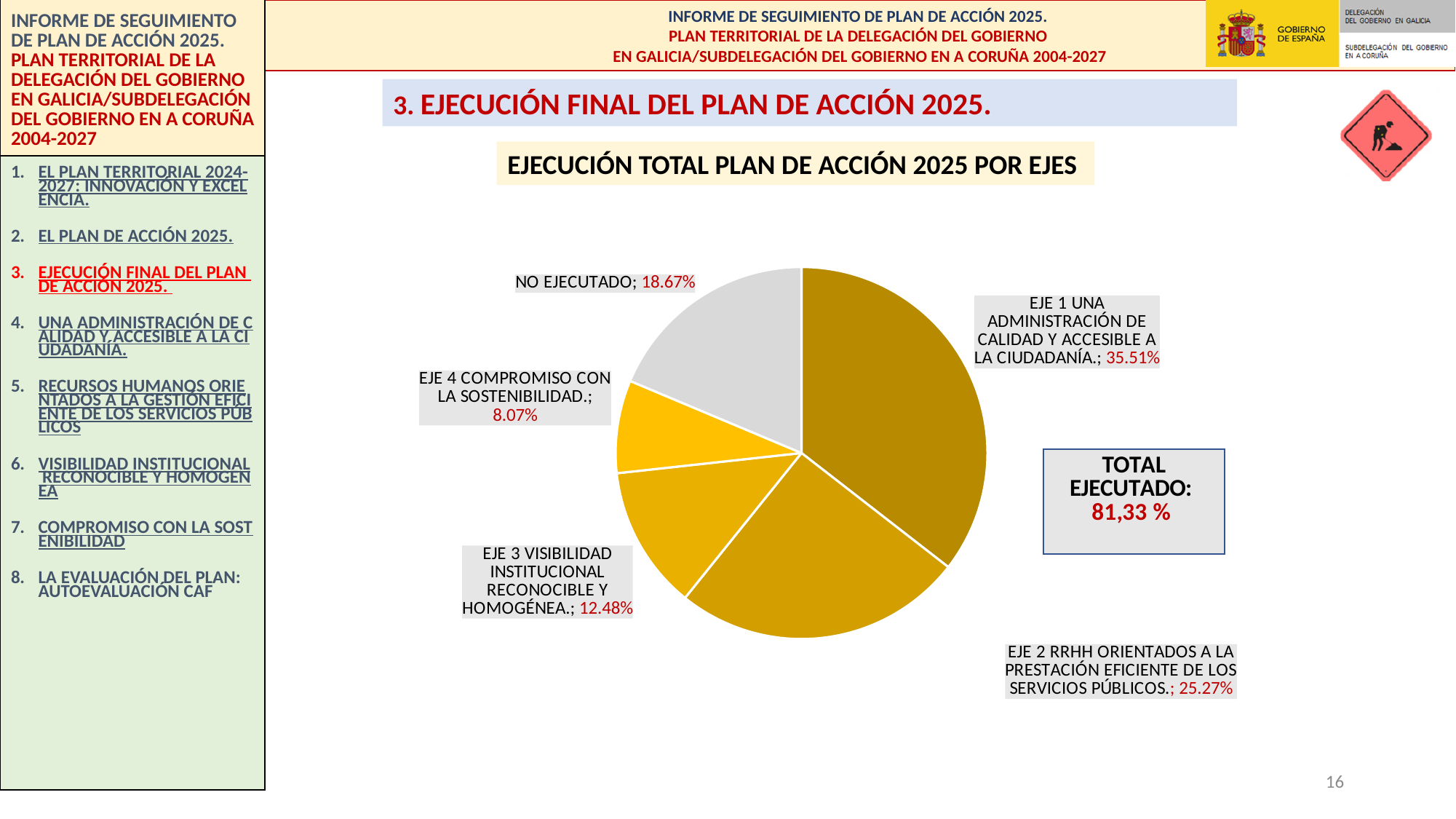
What kind of chart is shown on the slide? pie chart Which slice of the pie chart is the smallest? EJE 4 COMPROMISO CON LA SOSTENIBILIDAD What percentage is shown for EJE 1 UNA ADMINISTRACIÓN DE CALIDAD Y ACCESIBLE A LA CIUDADANÍA? 35.51% What percentage is shown for NO EJECUTADO? 18.67% How many slices does the pie chart have? 5 What is the title of the chart? EJECUCIÓN TOTAL PLAN DE ACCIÓN 2025 POR EJES Which slice of the pie chart is the largest? EJE 1 UNA ADMINISTRACIÓN DE CALIDAD Y ACCESIBLE A LA CIUDADANÍA What percentage is shown for EJE 4 COMPROMISO CON LA SOSTENIBILIDAD? 8.07% What percentage is shown for EJE 3 VISIBILIDAD INSTITUCIONAL RECONOCIBLE Y HOMOGÉNEA? 12.48% Which is larger, the share for EJE 2 or the share for NO EJECUTADO? EJE 2 What percentage is shown for EJE 2 RRHH ORIENTADOS A LA PRESTACIÓN EFICIENTE DE LOS SERVICIOS PÚBLICOS? 25.27% What is the difference between the share for EJE 1 and the share for EJE 2? 10.24%